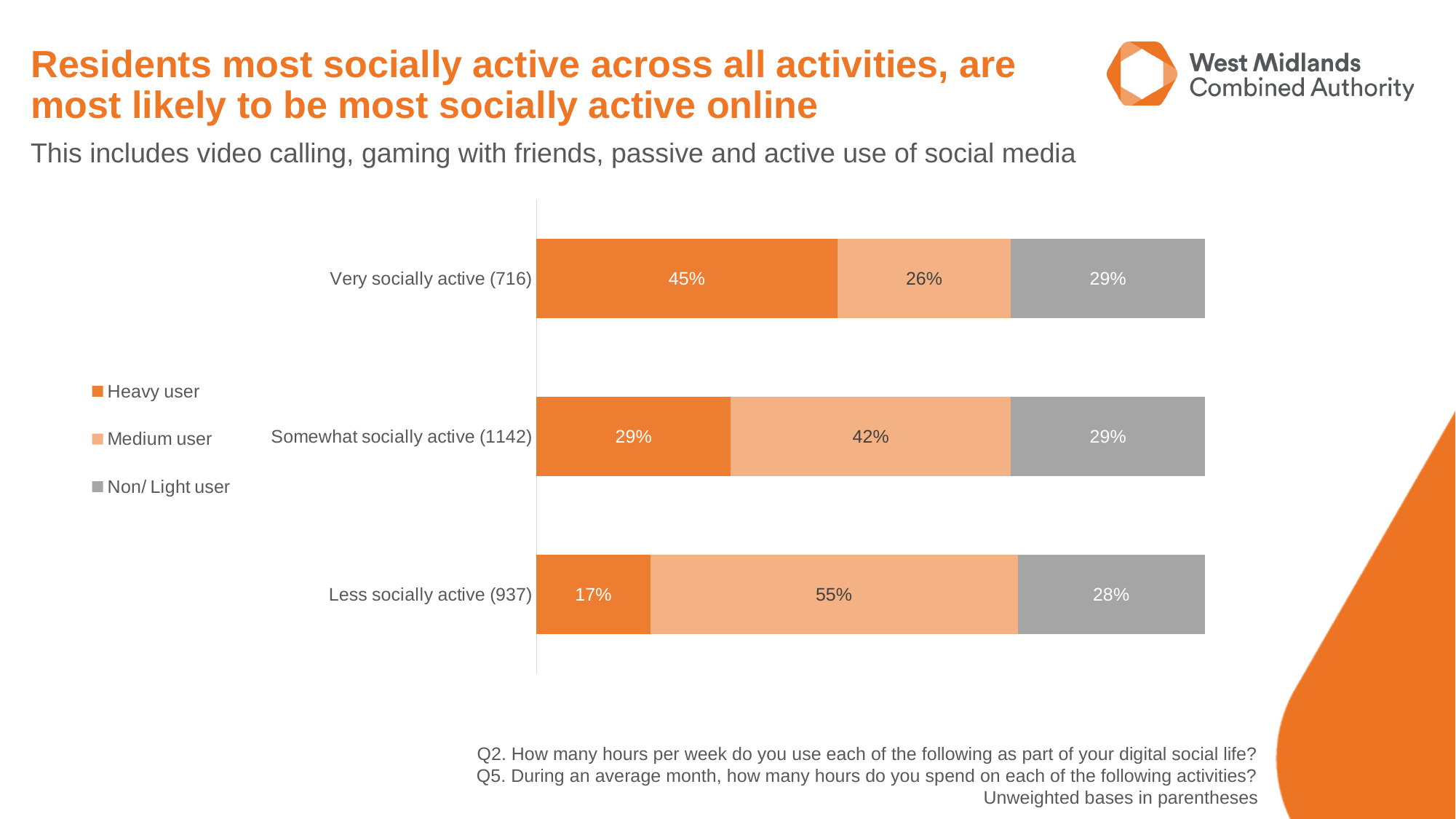
What percentage of the Very socially active group are Heavy users? 45% How many groups (categories) are shown on the chart? 3 Which group has the highest share of Heavy users? Very socially active (716) What is the difference in the Heavy user share between the Very socially active and Less socially active groups? 28 percentage points How many series does the legend list? 3 What is the unweighted base for the Somewhat socially active group? 1142 What percentage of the Somewhat socially active group are Non/ Light users? 29% What percentage of the Less socially active group are Medium users? 55% What is the total of the stacked bar for the Less socially active group? 100% Which is larger: the Medium user share for Somewhat socially active or for Very socially active? Somewhat socially active Which group has the lowest share of Heavy users? Less socially active (937) What kind of chart is shown on the slide? Stacked bar chart